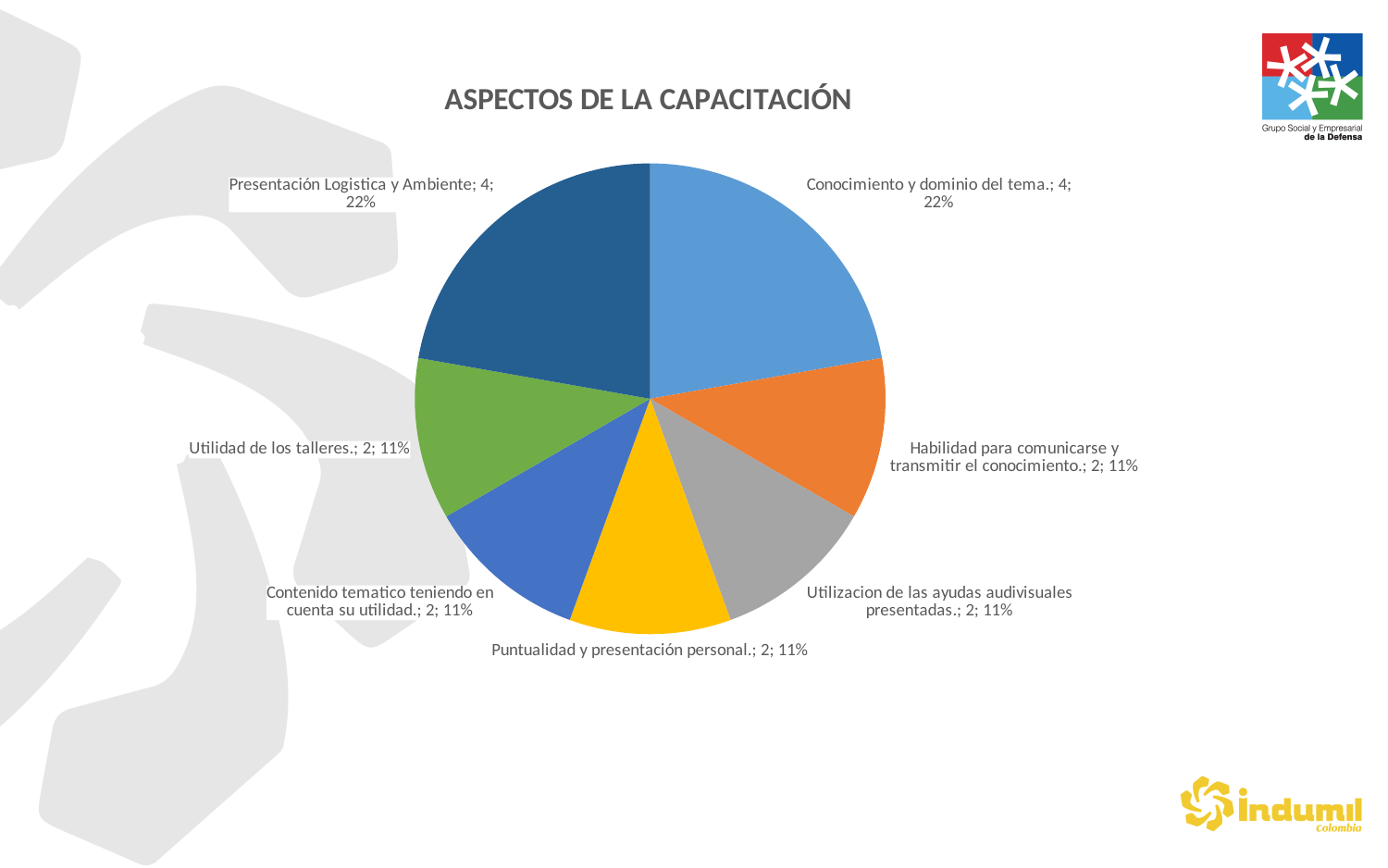
How many slices have a share of 11%? 5 What is the difference between the value for "Presentación Logistica y Ambiente" and the value for "Contenido tematico teniendo en cuenta su utilidad."? 2 How many slices does the pie chart have? 7 What value is shown for "Utilidad de los talleres."? 2 What percentage share is shown for "Puntualidad y presentación personal."? 11% What percentage share is shown for "Presentación Logistica y Ambiente"? 22% Which slice is larger: "Conocimiento y dominio del tema." or "Habilidad para comunicarse y transmitir el conocimiento."? Conocimiento y dominio del tema. What is the title of the chart? ASPECTOS DE LA CAPACITACIÓN What kind of chart is shown on the slide? pie chart What is the total of all the slice values in the pie chart? 18 What value is shown for "Conocimiento y dominio del tema."? 4 What colour is the slice for "Puntualidad y presentación personal."? yellow